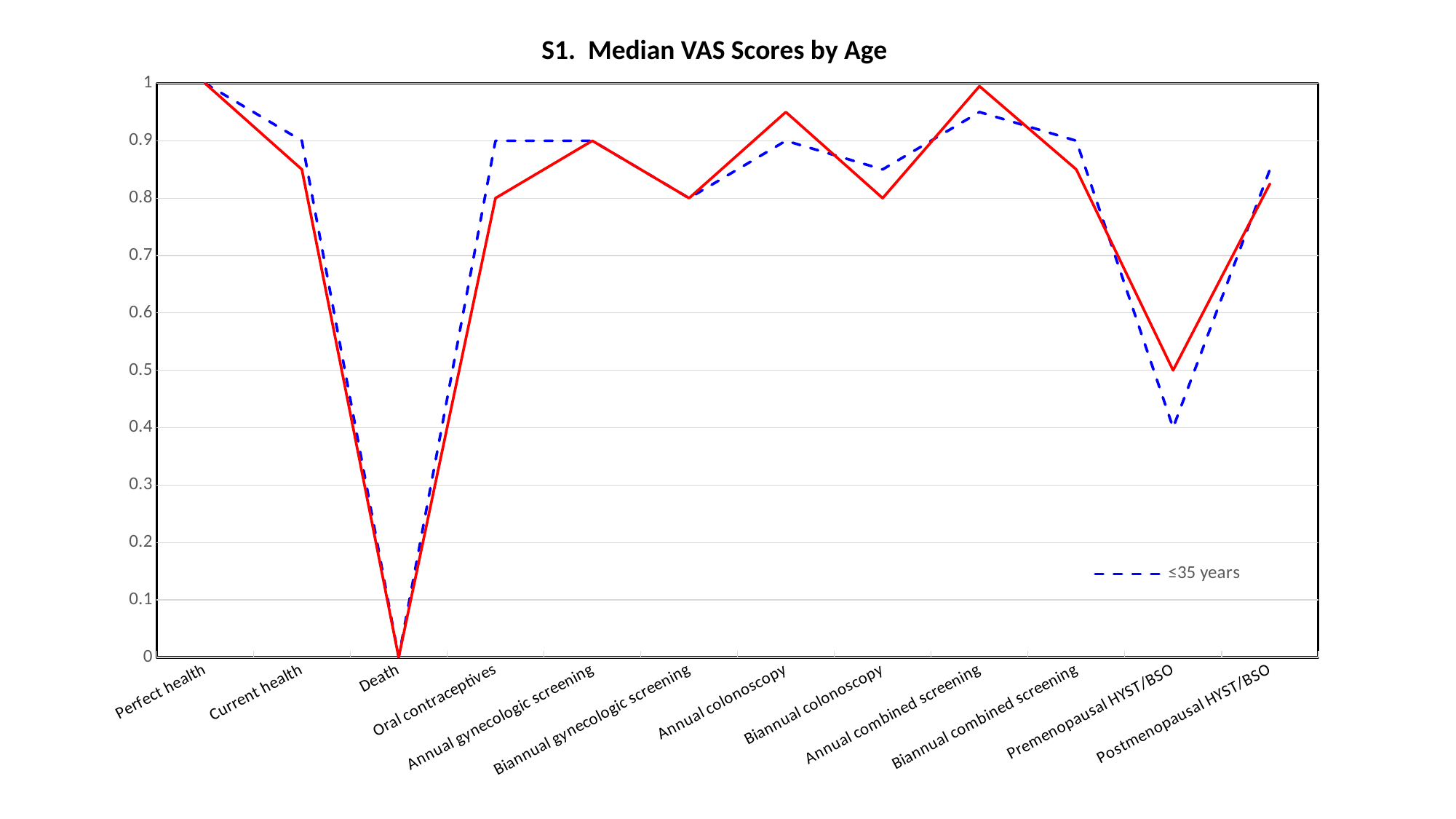
Which category has the lowest value for the ≤35 years series? Death Is the ≤35 years value for Premenopausal HYST/BSO greater or less than 0.5? less For Oral contraceptives, what is the difference between the ≤35 years value (0.9) and the red solid line value (0.8)? 0.1 Which category has the highest value for the ≤35 years series? Perfect health What is the median VAS score for Oral contraceptives for the ≤35 years (blue dashed) series? 0.9 For Oral contraceptives, which line has the larger value, the blue dashed ≤35 years line or the red solid line? blue dashed ≤35 years line What is the title of the chart? S1. Median VAS Scores by Age What kind of chart is shown on the slide? line chart How many series does the legend list? 1 How many categories are shown along the x axis? 12 What is the median VAS score for Death for the ≤35 years series? 0 What is the value of the red solid line for Premenopausal HYST/BSO? 0.5